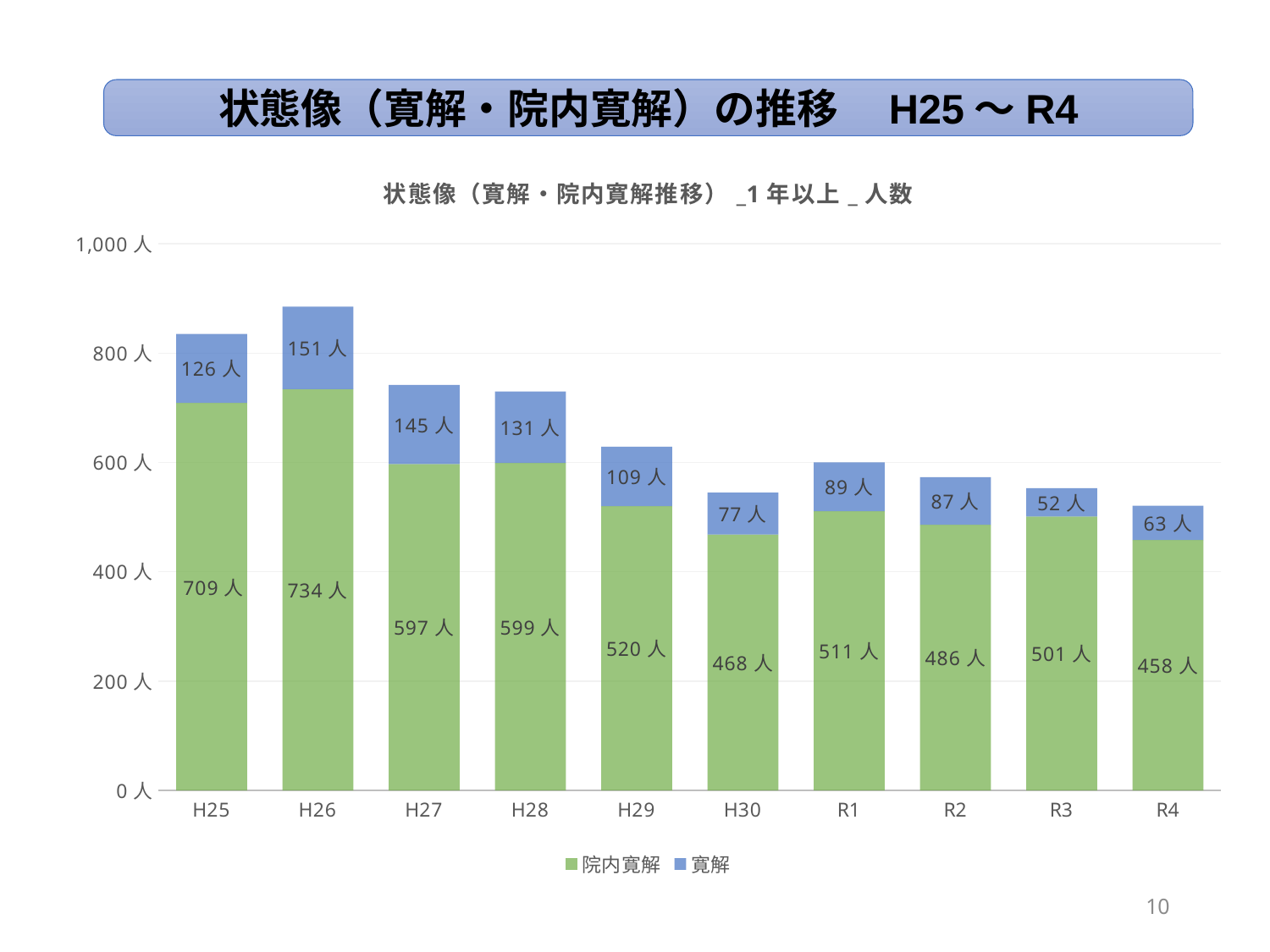
What is the value of 寛解 for H29? 109 人 What is the difference between the 院内寛解 values for H25 and H30? 241 人 How many series does the legend list? 2 What kind of chart is shown on the slide? Stacked bar chart Which is larger, the 寛解 value for R3 or for R4? R4 What is the total of the stacked bar for H26? 885 人 What is the value of 院内寛解 for R4? 458 人 What is the value of 院内寛解 for H26? 734 人 What is the total of the stacked bar for R1? 600 人 How many years are shown on the x axis? 10 Which year has the highest 寛解 value? H26 Which year has the lowest 院内寛解 value? R4